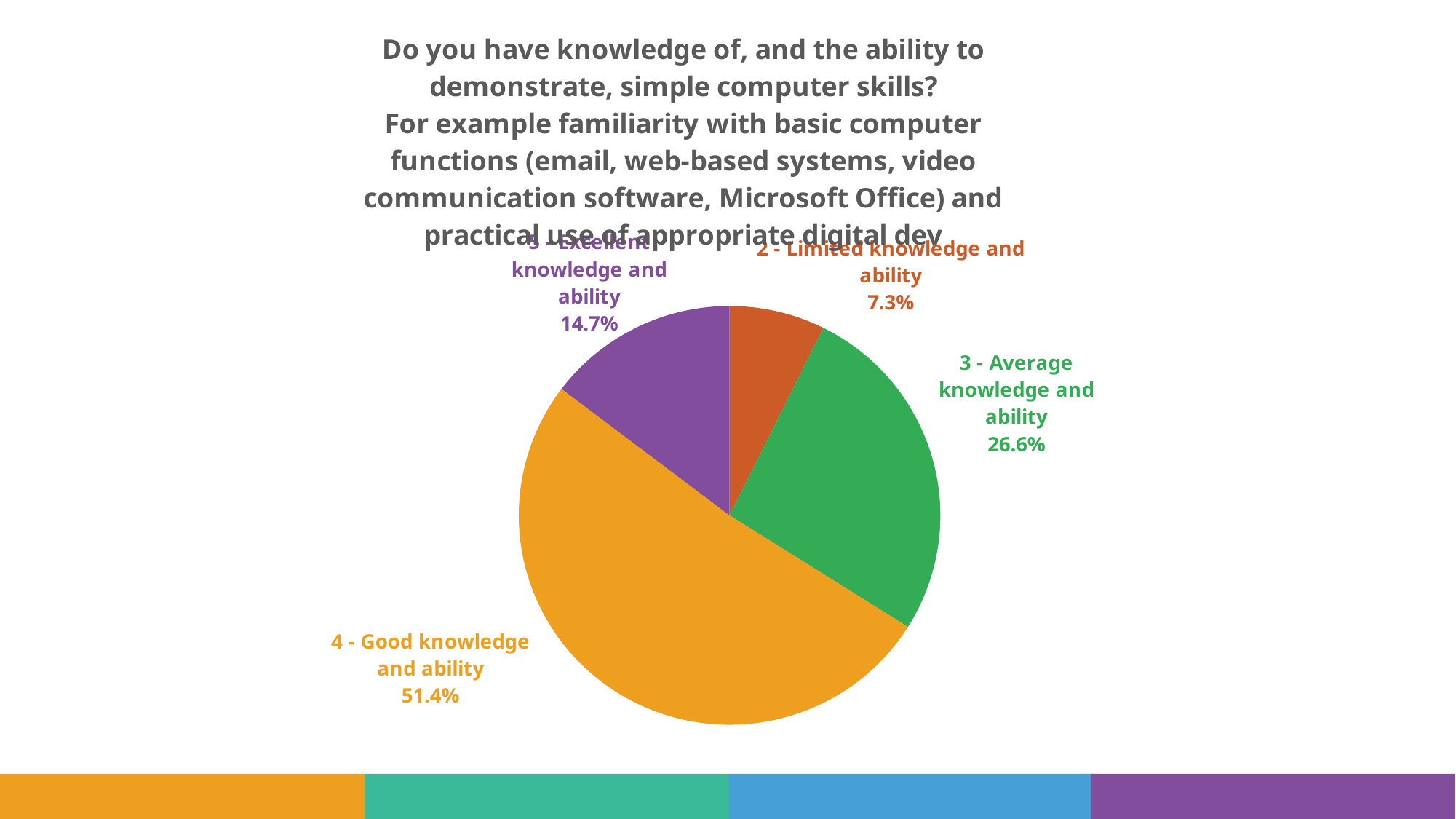
Which response has the largest slice of the pie? 4 - Good knowledge and ability How many slices does the pie chart have? 4 What is the difference in percentage points between "5 - Excellent knowledge and ability" and "2 - Limited knowledge and ability"? 7.4 What colour is the slice for "3 - Average knowledge and ability"? Green What share of respondents answered "2 - Limited knowledge and ability"? 7.3% What share of respondents answered "5 - Excellent knowledge and ability"? 14.7% What kind of chart is shown on the slide? Pie chart What share of respondents answered "4 - Good knowledge and ability"? 51.4% What share of respondents answered "3 - Average knowledge and ability"? 26.6% Which is larger: the share for "5 - Excellent knowledge and ability" or the share for "2 - Limited knowledge and ability"? 5 - Excellent knowledge and ability Which response has the smallest slice of the pie? 2 - Limited knowledge and ability What is the difference in percentage points between "4 - Good knowledge and ability" and "3 - Average knowledge and ability"? 24.8